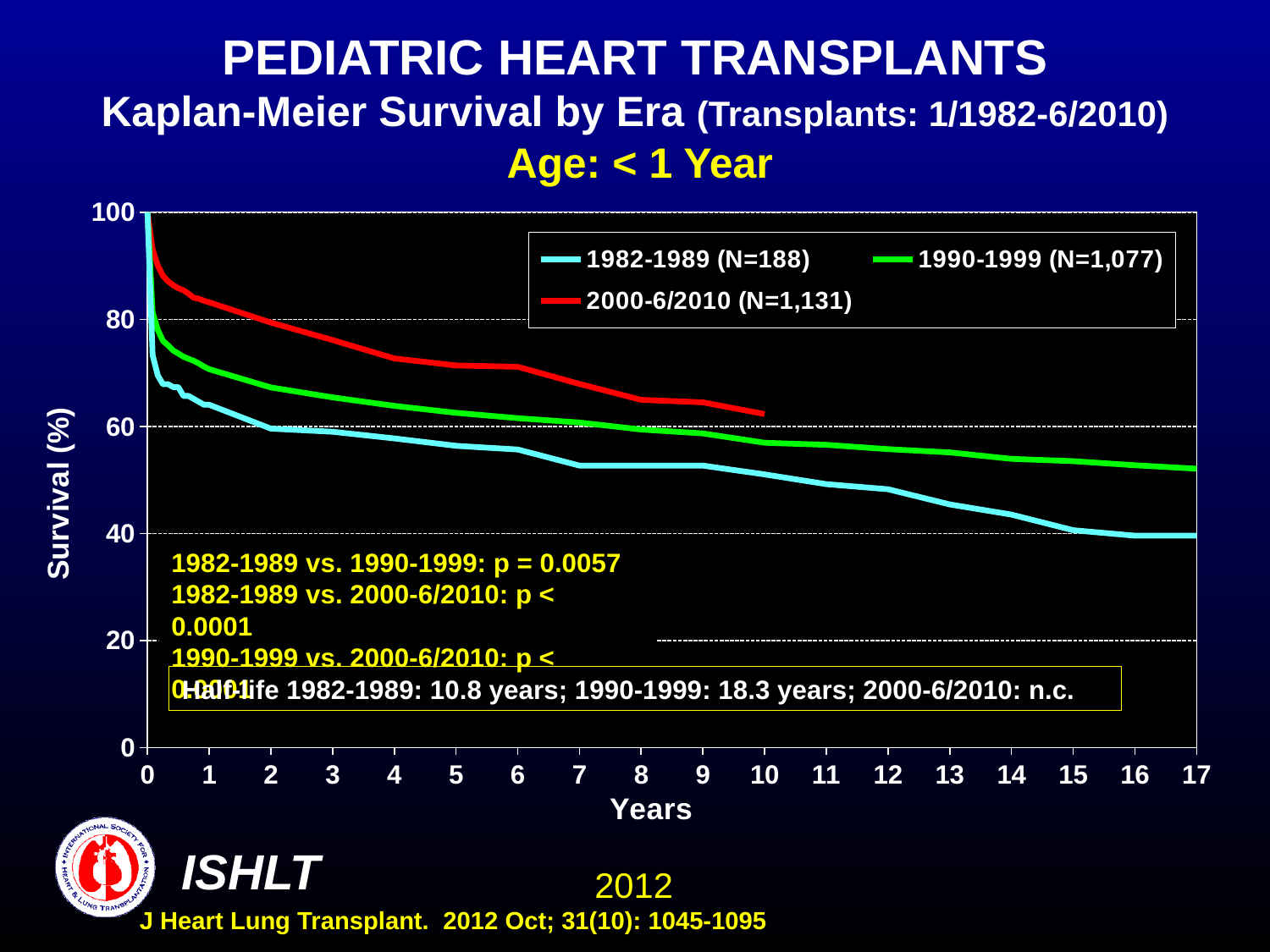
According to the legend, what is the N for the 2000-6/2010 era? 1,131 At year 5, which era has higher survival: 2000-6/2010 or 1982-1989? 2000-6/2010 Is the survival for the 1990-1999 era at year 17 greater or less than 40? greater Do the survival curves rise or fall as years increase? fall What is the label on the vertical axis? Survival (%) Is the survival for the 2000-6/2010 era at year 5 greater or less than 60? greater What kind of chart is shown on the slide? line chart How many series does the legend list? 3 Is the survival for the 2000-6/2010 era at year 1 greater or less than 80? greater Which era has the lowest survival at year 8? 1982-1989 Which era has the highest survival at year 8? 2000-6/2010